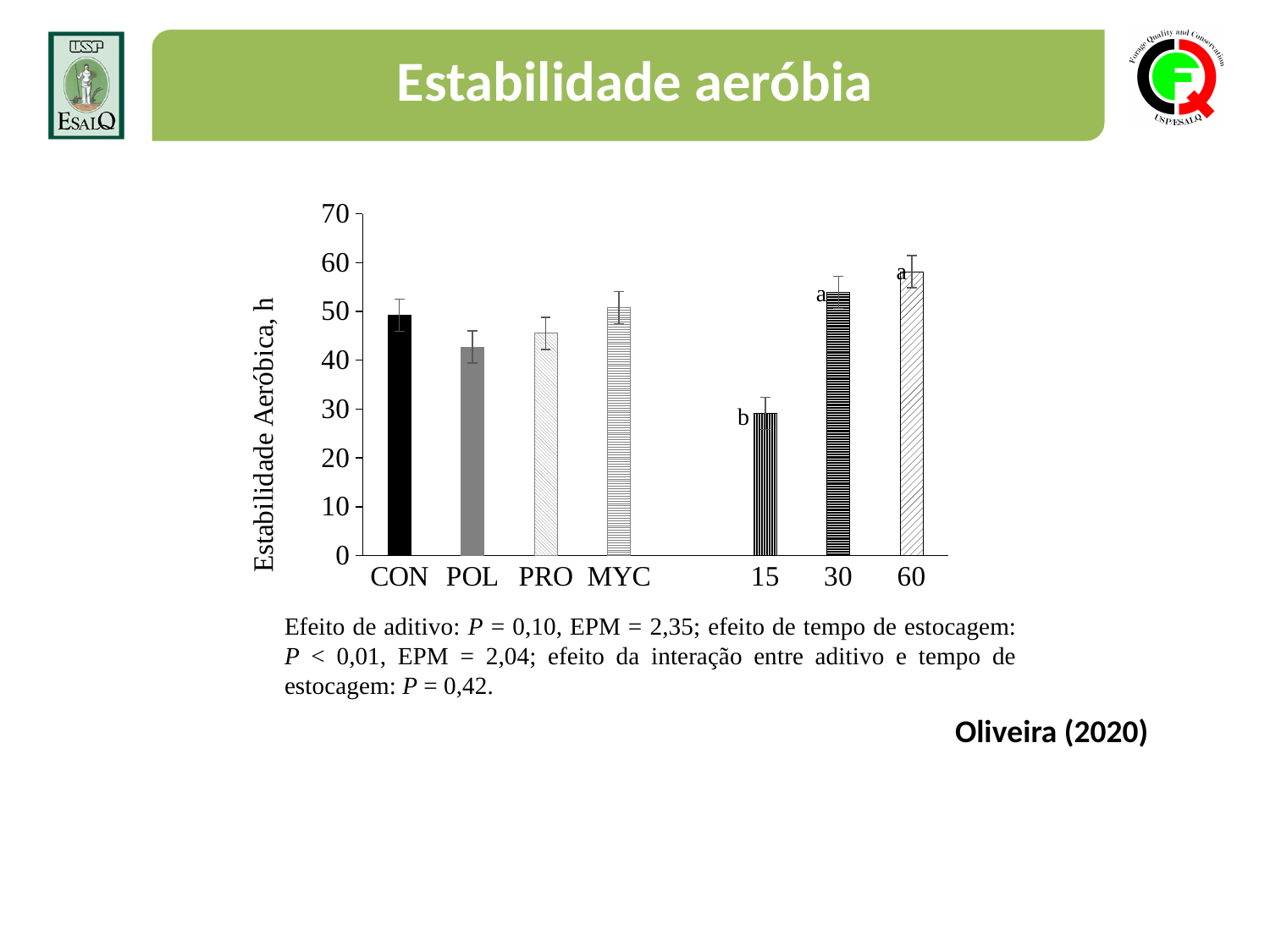
Is the value for 15 greater or less than 40? less Which category has the highest aerobic stability? 60 Which is larger, the value for CON or the value for POL? CON Which category has the lowest aerobic stability? 15 Is the value for POL greater or less than 50? less How many categories are plotted on the x axis? 7 What kind of chart is shown on the slide? bar chart Do the values rise or fall across the storage times 15, 30 and 60? rise Is the value for 30 greater or less than 50? greater What is the label of the y axis? Estabilidade Aeróbica, h Which is larger, the value for 15 or the value for 30? 30